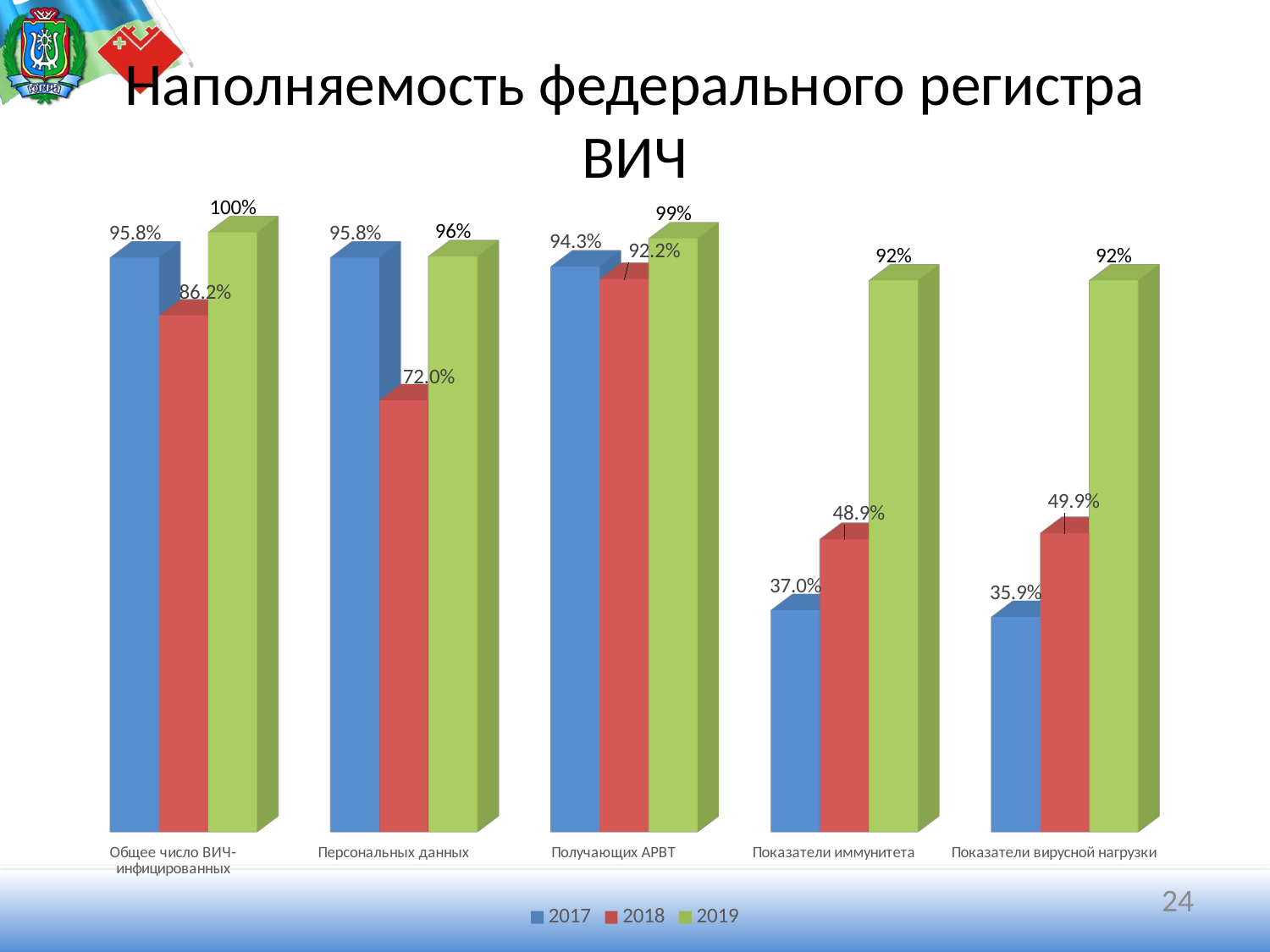
What kind of chart is shown on the slide? Bar chart What is the 2018 value for Показатели иммунитета? 48.9% What is the 2019 value for Общее число ВИЧ-инфицированных? 100% What is the 2018 value for Персональных данных? 72.0% Which category has the highest 2019 value? Общее число ВИЧ-инфицированных How many series does the legend list? 3 Which colour represents the 2019 series in the legend? Green Which is larger for Получающих АРВТ: the 2017 value or the 2018 value? 2017 How many categories are shown on the x axis? 5 What is the 2017 value for Показатели вирусной нагрузки? 35.9% Which category has the lowest 2017 value? Показатели вирусной нагрузки What is the difference between the 2019 and 2017 values for Показатели иммунитета? 55%